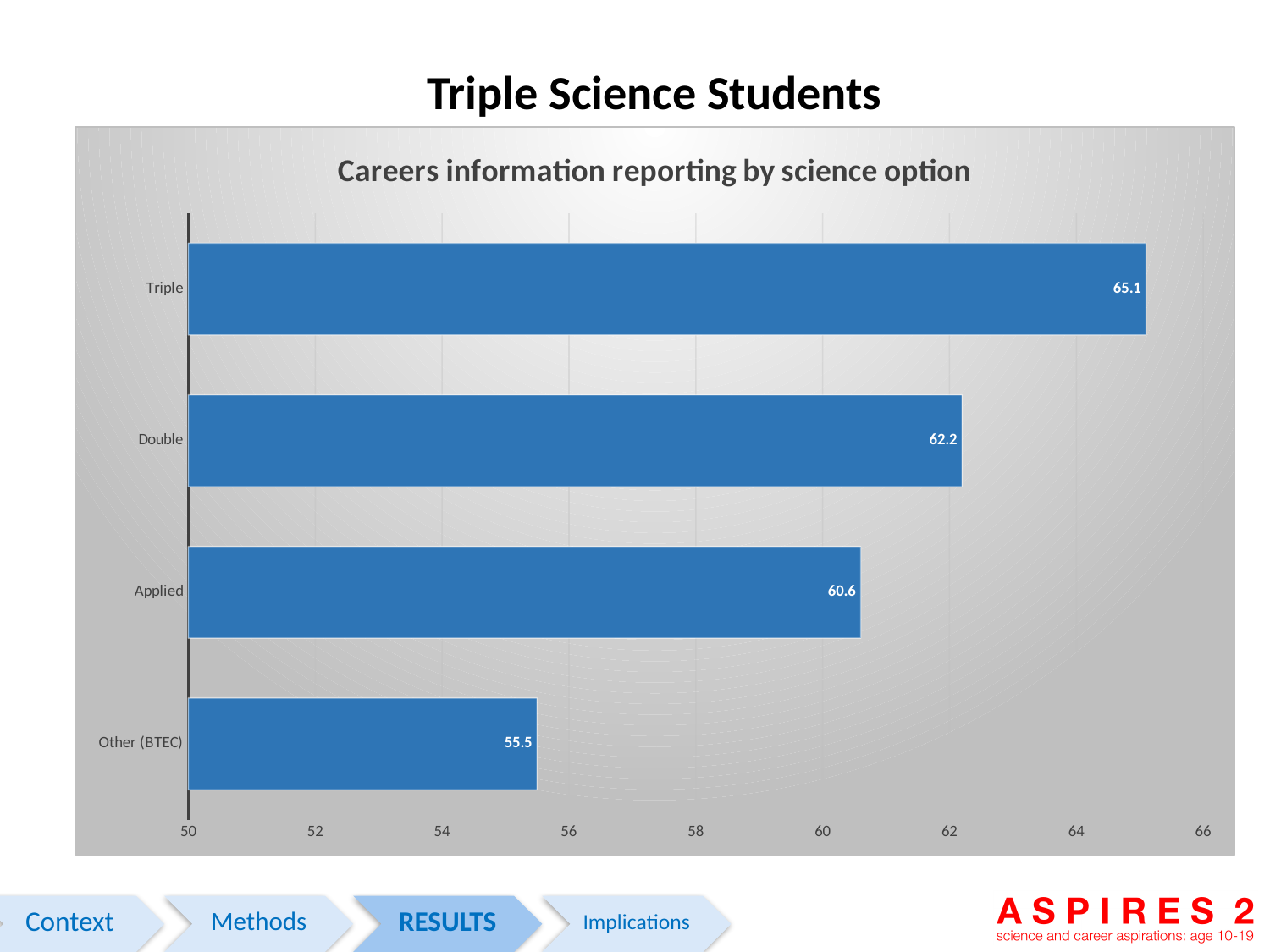
What is the difference between the values for Triple and Other (BTEC)? 9.6 Which science option has the lowest value? Other (BTEC) What type of chart is shown on the slide? Bar chart What is the value for Other (BTEC) in the chart? 55.5 What is the value for Triple in the chart? 65.1 Is the value for Other (BTEC) greater or less than 56? less What is the value for Applied in the chart? 60.6 Which is larger, the value for Double or the value for Applied? Double What is the difference between the values for Double and Applied? 1.6 What is the value for Double in the chart? 62.2 Which science option has the highest value? Triple How many science options are shown in the chart? 4